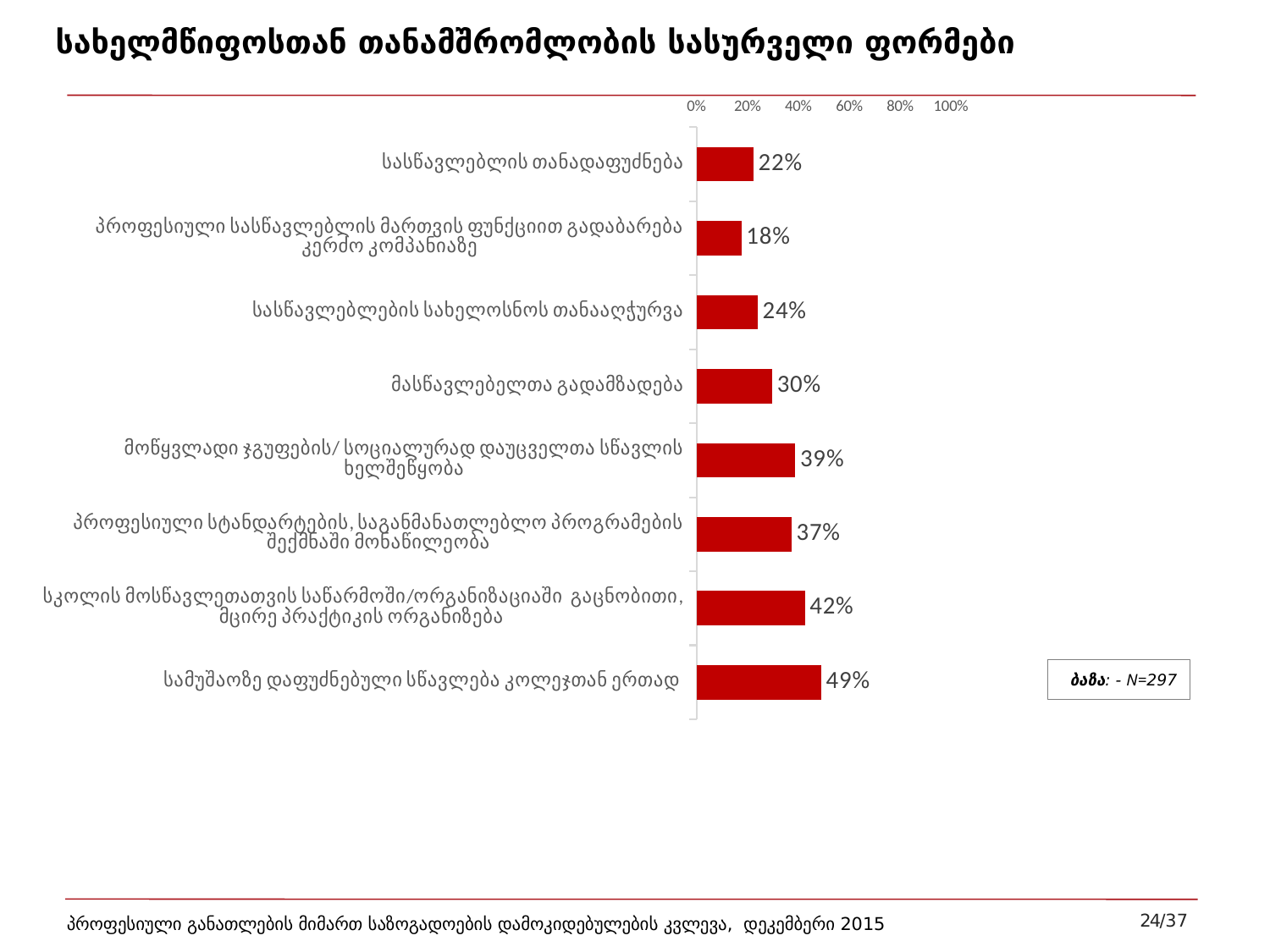
Which category has the highest value? სამუშაოზე დაფუძნებული სწავლება კოლეჯთან ერთად What is the value for "მასწავლებელთა გადამზადება"? 30% What is the difference between the values for "სამუშაოზე დაფუძნებული სწავლება კოლეჯთან ერთად" and "სასწავლებლის თანადაფუძნება"? 27% How many categories are shown in the chart? 8 What is the value for "სასწავლებლის თანადაფუძნება"? 22% What is the value for "სამუშაოზე დაფუძნებული სწავლება კოლეჯთან ერთად"? 49% What is the value for "სასწავლებლების სახელოსნოს თანააღჭურვა"? 24% What sample size (N) is stated in the note on the slide? N=297 Which category has the lowest value? პროფესიული სასწავლებლის მართვის ფუნქციით გადაბარება კერძო კომპანიაზე What kind of chart is shown on the slide? bar chart Which is larger: the value for "მოწყვლადი ჯგუფების/ სოციალურად დაუცველთა სწავლის ხელშეწყობა" or for "პროფესიული სტანდარტების, საგანმანათლებლო პროგრამების შექმნაში მონაწილეობა"? მოწყვლადი ჯგუფების/ სოციალურად დაუცველთა სწავლის ხელშეწყობა Is the value for "სკოლის მოსწავლეთათვის საწარმოში/ორგანიზაციაში გაცნობითი, მცირე პრაქტიკის ორგანიზება" greater or less than 40%? greater